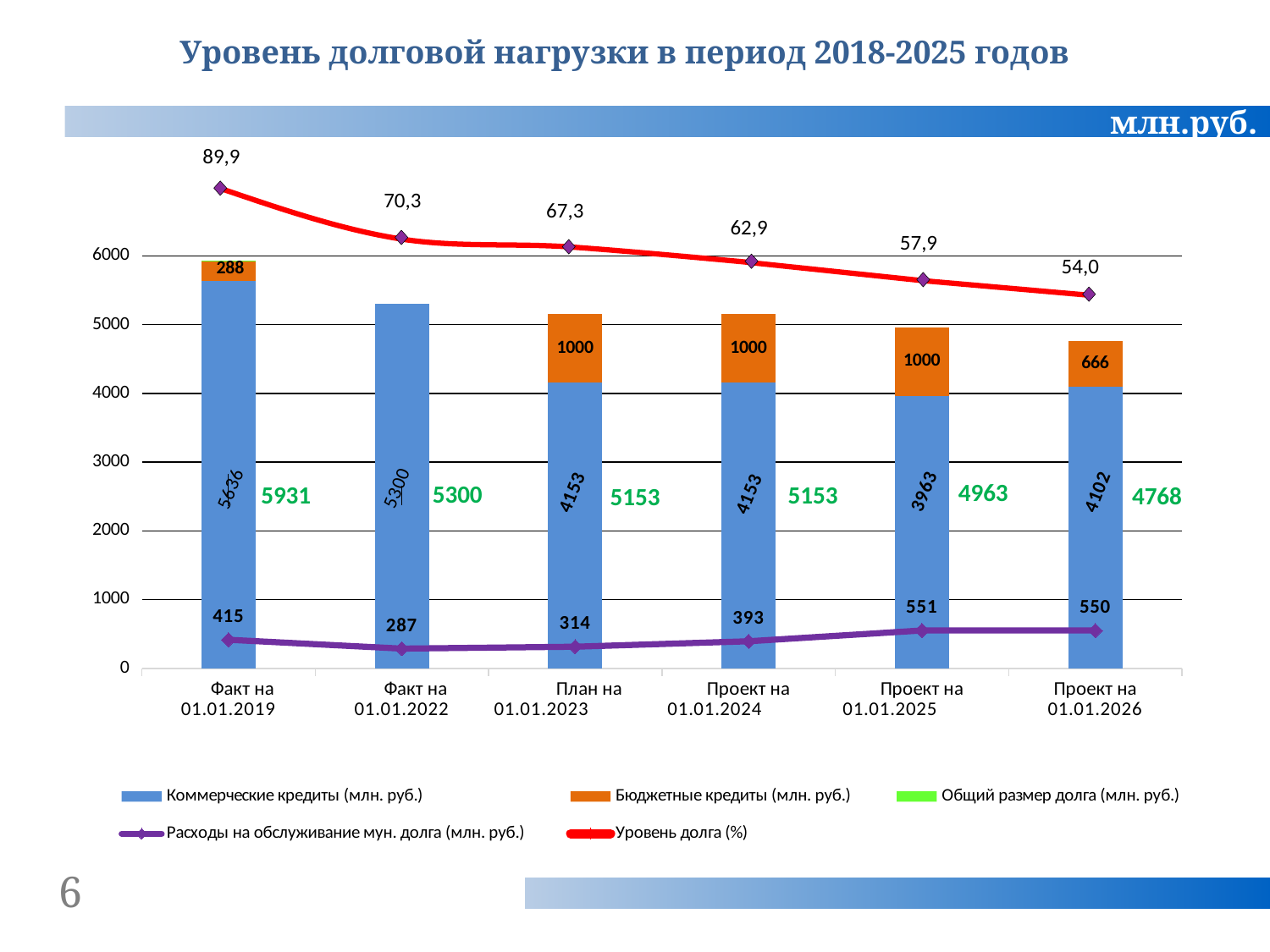
What is the value of Расходы на обслуживание мун. долга for План на 01.01.2023? 314 What is the value of Коммерческие кредиты for Проект на 01.01.2025? 3963 What is the difference in Уровень долга (%) between Факт на 01.01.2019 and Проект на 01.01.2026? 35,9 Which is larger, Коммерческие кредиты for Факт на 01.01.2019 or for Факт на 01.01.2022? Факт на 01.01.2019 What is the value of Уровень долга (%) for Факт на 01.01.2019? 89,9 What is the value of Бюджетные кредиты for Проект на 01.01.2026? 666 How many categories are shown on the x axis? 6 What is the total debt (Общий размер долга) shown for Проект на 01.01.2024? 5153 For which category is Расходы на обслуживание мун. долга the lowest? Факт на 01.01.2022 Does Уровень долга (%) rise or fall from Факт на 01.01.2019 to Проект на 01.01.2026? fall How many series does the legend list? 5 For which category is Уровень долга (%) the lowest? Проект на 01.01.2026